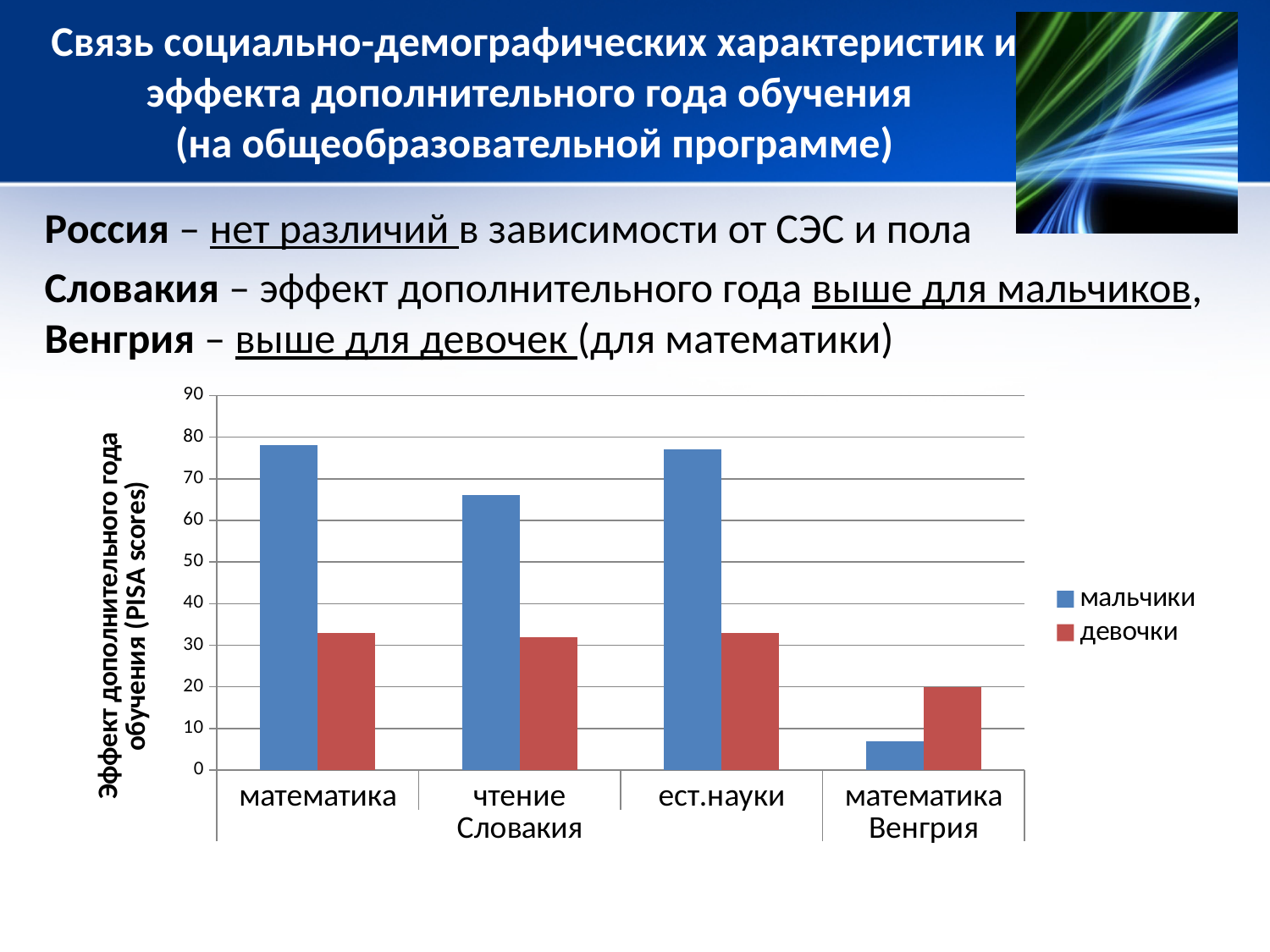
For математика in Венгрия, which is larger: the value for мальчики or for девочки? девочки For математика in Словакия, which is larger: the value for мальчики or for девочки? мальчики What is the label of the vertical axis of the chart? Эффект дополнительного года обучения (PISA scores) How many series does the chart legend list? 2 Which category has the lowest value for мальчики? математика (Венгрия) Is the value for девочки in чтение (Словакия) greater or less than 40? less How many categories are shown along the x axis of the chart? 4 Which category has the lowest value for девочки? математика (Венгрия) Is the value for мальчики in математика (Венгрия) greater or less than 10? less What kind of chart is shown on the slide? bar chart Is the value for мальчики in чтение (Словакия) greater or less than 60? greater